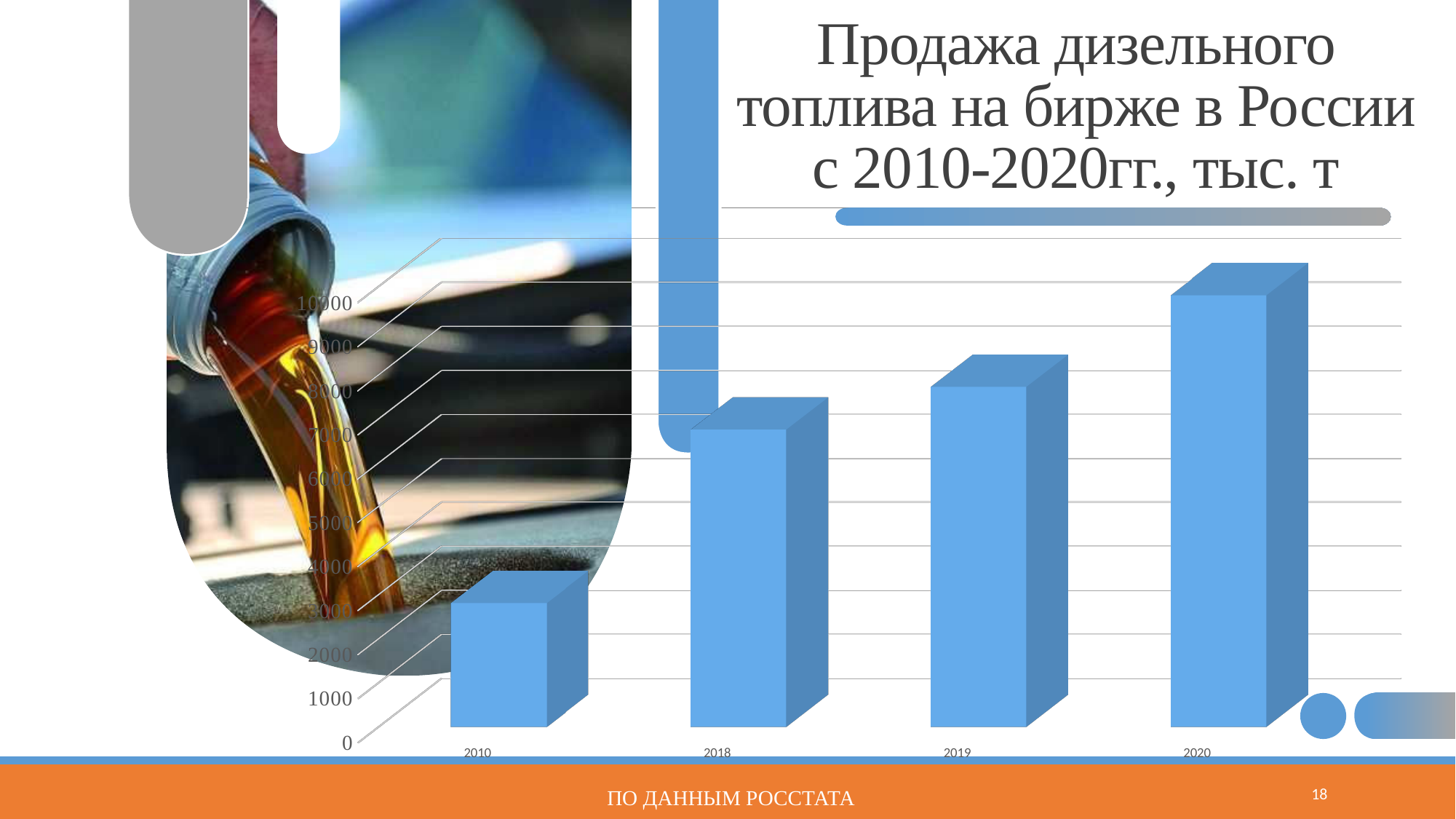
How many years (categories) are plotted on the chart? 4 Which year has the highest diesel fuel sales on the chart? 2020 Do the values rise or fall from 2010 to 2020 along the x axis? rise Is the value for 2010 greater or less than 4000? less Which year has the larger value, 2010 or 2020? 2020 Is the value for 2018 greater or less than 5000? greater Is the value for 2019 greater or less than 9000? less Which year has the larger value, 2018 or 2019? 2019 Which year has the lowest diesel fuel sales on the chart? 2010 What is the title of the chart on the slide? Продажа дизельного топлива на бирже в России с 2010-2020гг., тыс. т What kind of chart is shown on the slide? bar chart